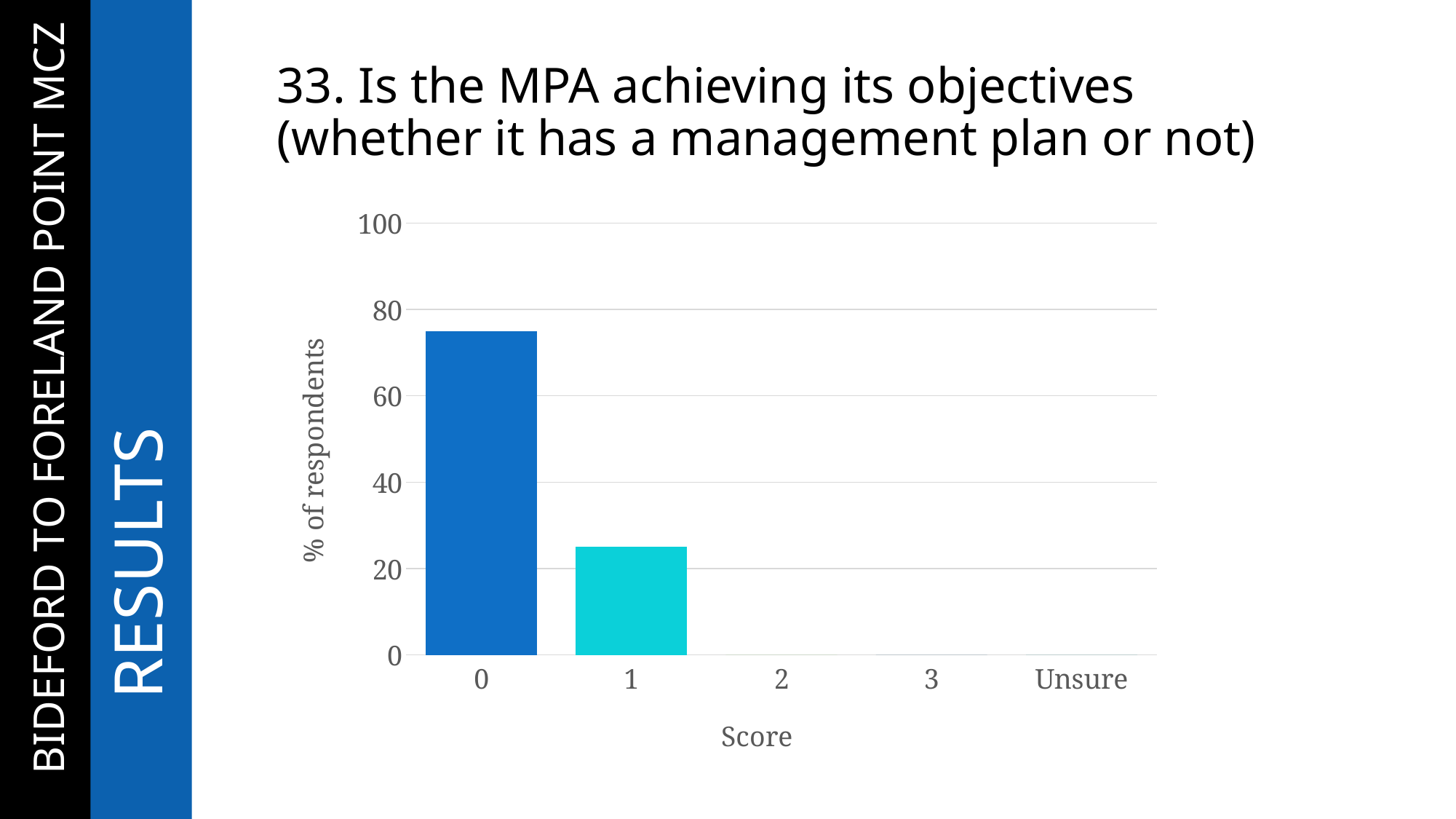
Is the value for score 0 greater or less than 60? greater What kind of chart is shown on the slide? bar chart Which score category has the highest percentage of respondents? 0 Is the value for score 1 greater or less than 20? greater Is the value for score 0 greater or less than 80? less Which has a higher percentage of respondents, score 0 or score 1? 0 How many score categories are shown on the x axis? 5 How many score categories have a visible bar? 2 What is the label of the y axis? % of respondents What is the label of the x axis? Score Do the values rise or fall from score 0 to score 1? fall